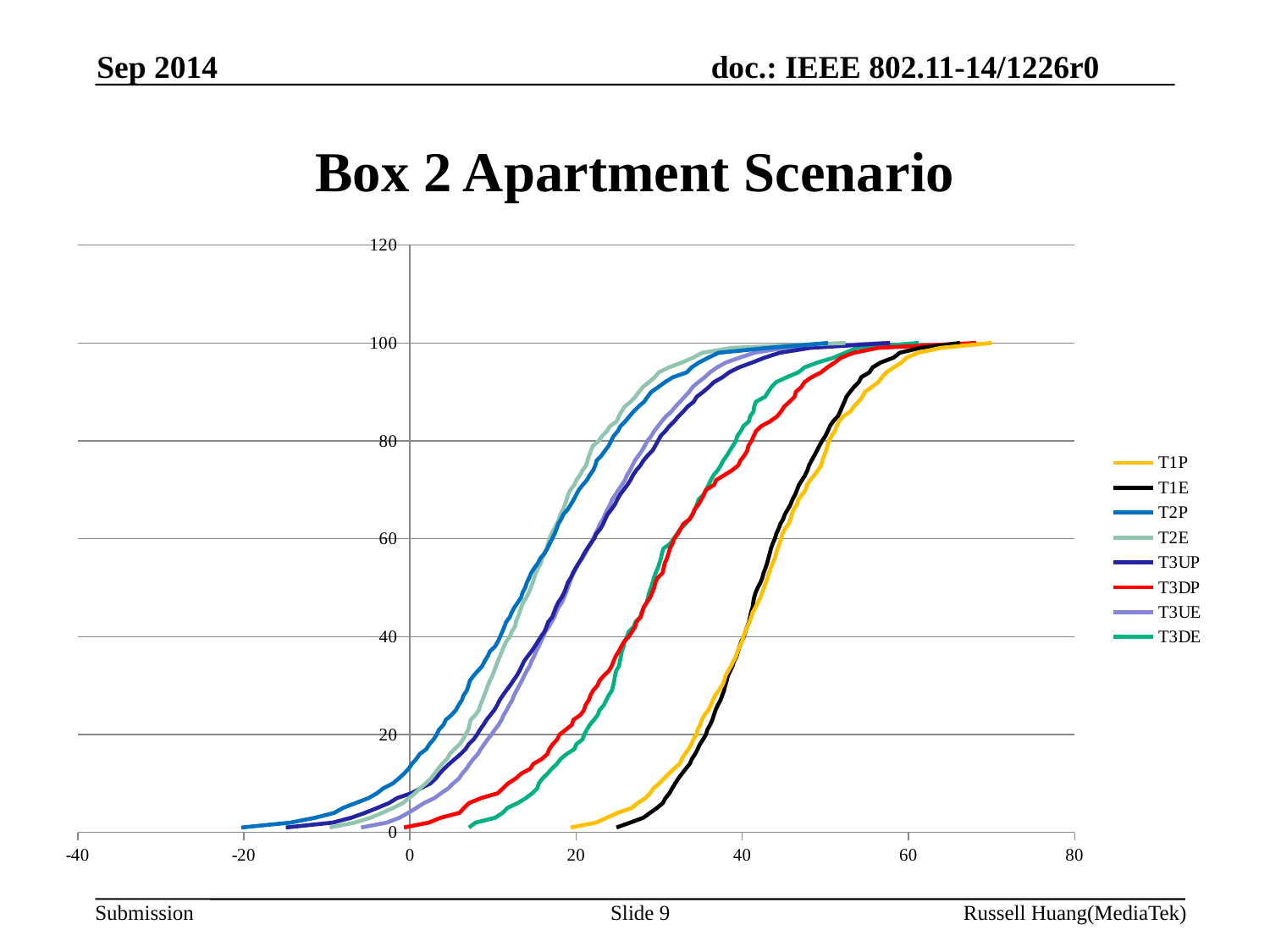
Do the curves rise or fall as the x-axis value increases? rise Is the value of the T1E curve at x = 30 greater or less than 20? less How many series does the legend list? 8 Which series begins at the lowest x-axis value (furthest left)? T2P What is the title of the chart? Box 2 Apartment Scenario Is the value of the T1P curve at x = 60 greater or less than 80? greater Is the value of the T2E curve at x = 40 greater or less than 80? greater What kind of chart is shown on the slide? line chart At x = 20, which curve has the higher value, T2P or T1P? T2P Which series is listed first in the legend? T1P